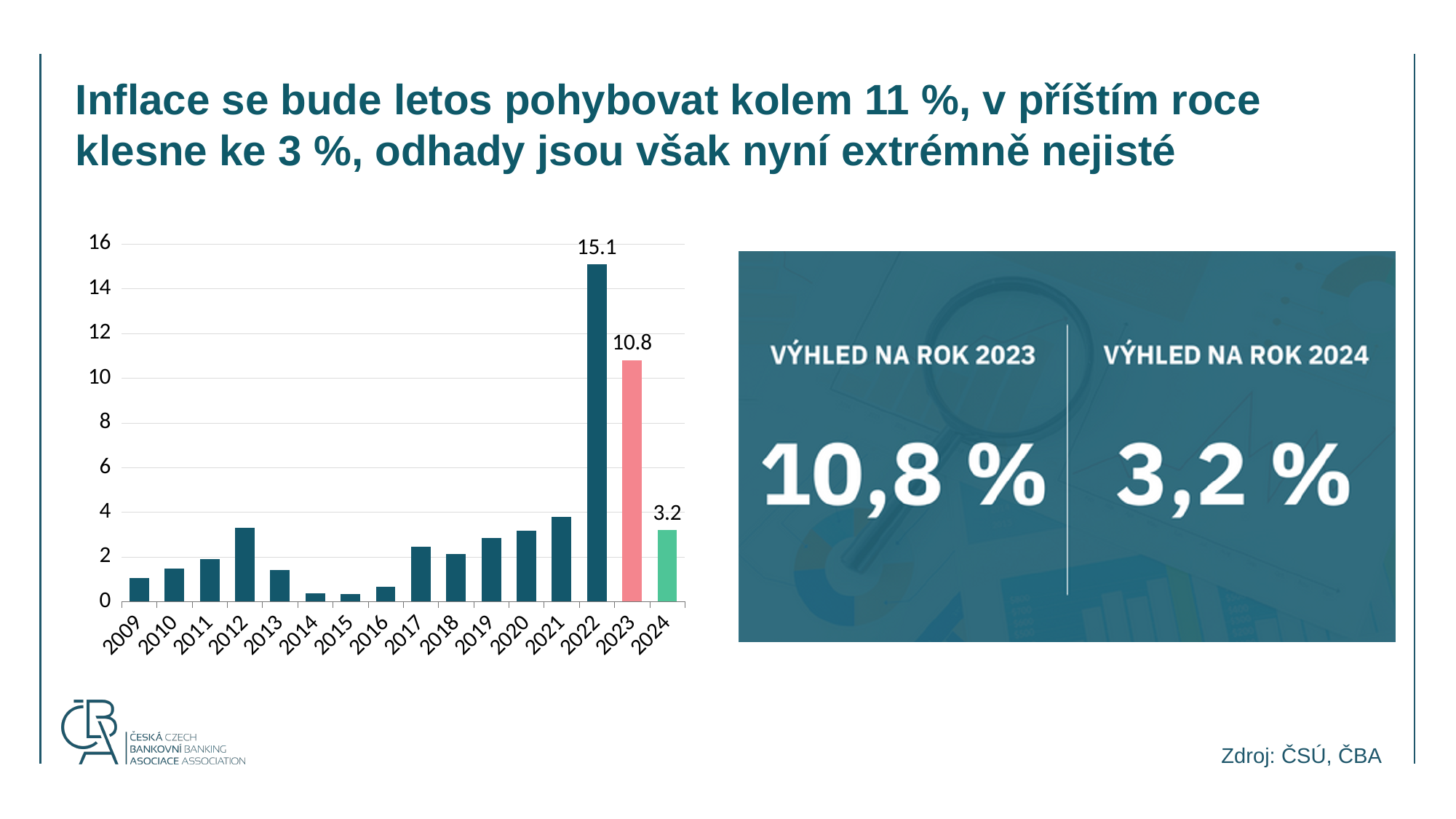
What is the value for 2024? 3.2 What is the difference between the values for 2023 and 2024? 7.6 Which is larger, the value for 2023 or the value for 2024? 2023 Which year has the highest bar? 2022 What kind of chart is shown on the slide? bar chart Is the value for 2012 greater or less than 4? less Is the value for 2021 greater or less than 2? greater How many years are shown on the x axis of the chart? 16 What is the value for 2023? 10.8 What is the difference between the values for 2022 and 2023? 4.3 What is the value for 2022? 15.1 What colour is the bar for 2024? green